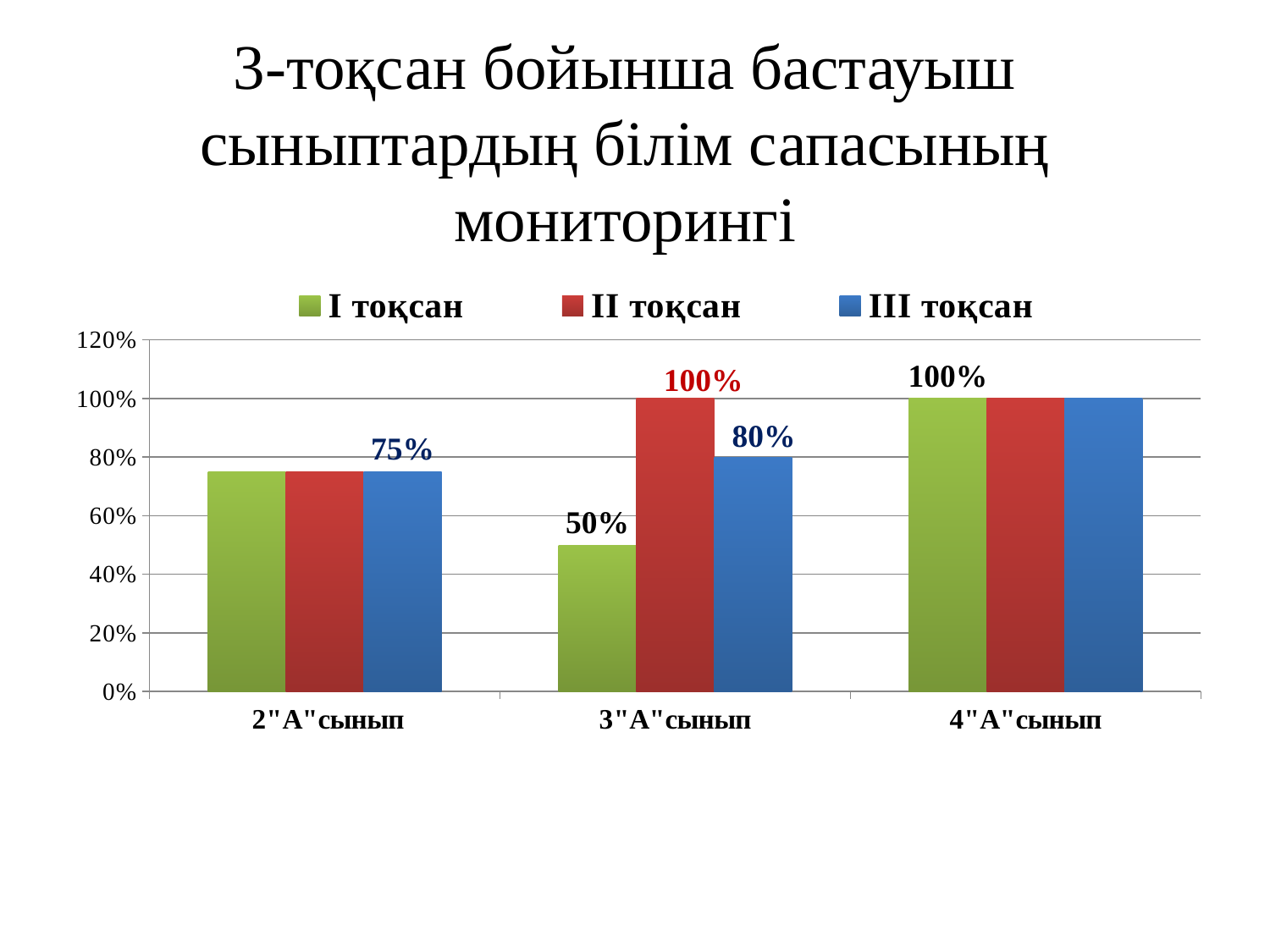
In the 3"А"сынып category, which is larger: the I тоқсан value or the III тоқсан value? III тоқсан In the 3"А"сынып category, which series has the lowest value? I тоқсан Is the value for I тоқсан in the 2"А"сынып category greater or less than 60%? greater How many categories are shown on the x axis of the chart? 3 In the 3"А"сынып category, what is the difference between the II тоқсан and I тоқсан values? 50% How many series does the legend list? 3 What is the value for III тоқсан in the 3"А"сынып category? 80% What is the value for I тоқсан in the 4"А"сынып category? 100% What is the value for III тоқсан in the 2"А"сынып category? 75% In the 3"А"сынып category, what is the difference between the II тоқсан and III тоқсан values? 20% What is the value for I тоқсан in the 3"А"сынып category? 50% What is the value for II тоқсан in the 3"А"сынып category? 100%